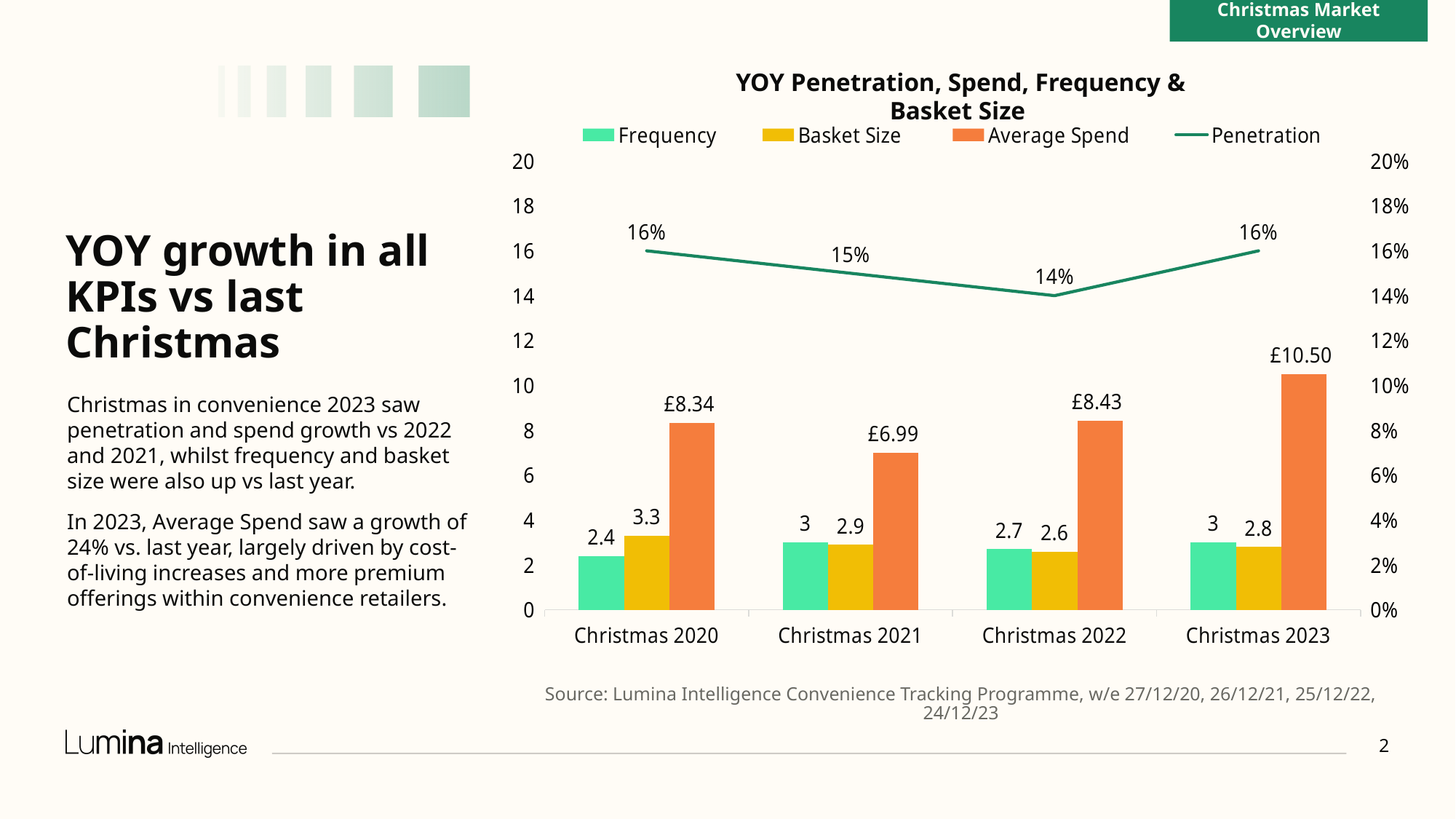
What is the Frequency value for Christmas 2020? 2.4 What is the Basket Size for Christmas 2021? 2.9 What is the Penetration value for Christmas 2022? 14% What is the difference in Average Spend between Christmas 2023 and Christmas 2022? £2.07 What is the Average Spend for Christmas 2023? £10.50 How many series does the legend list? 4 Which is larger, the Basket Size for Christmas 2020 or for Christmas 2023? Christmas 2020 How many Christmas periods are shown on the x axis? 4 Which series is plotted as a line rather than bars? Penetration Which Christmas has the highest Average Spend? Christmas 2023 Which Christmas has the lowest Average Spend? Christmas 2021 What is the title of the chart? YOY Penetration, Spend, Frequency & Basket Size